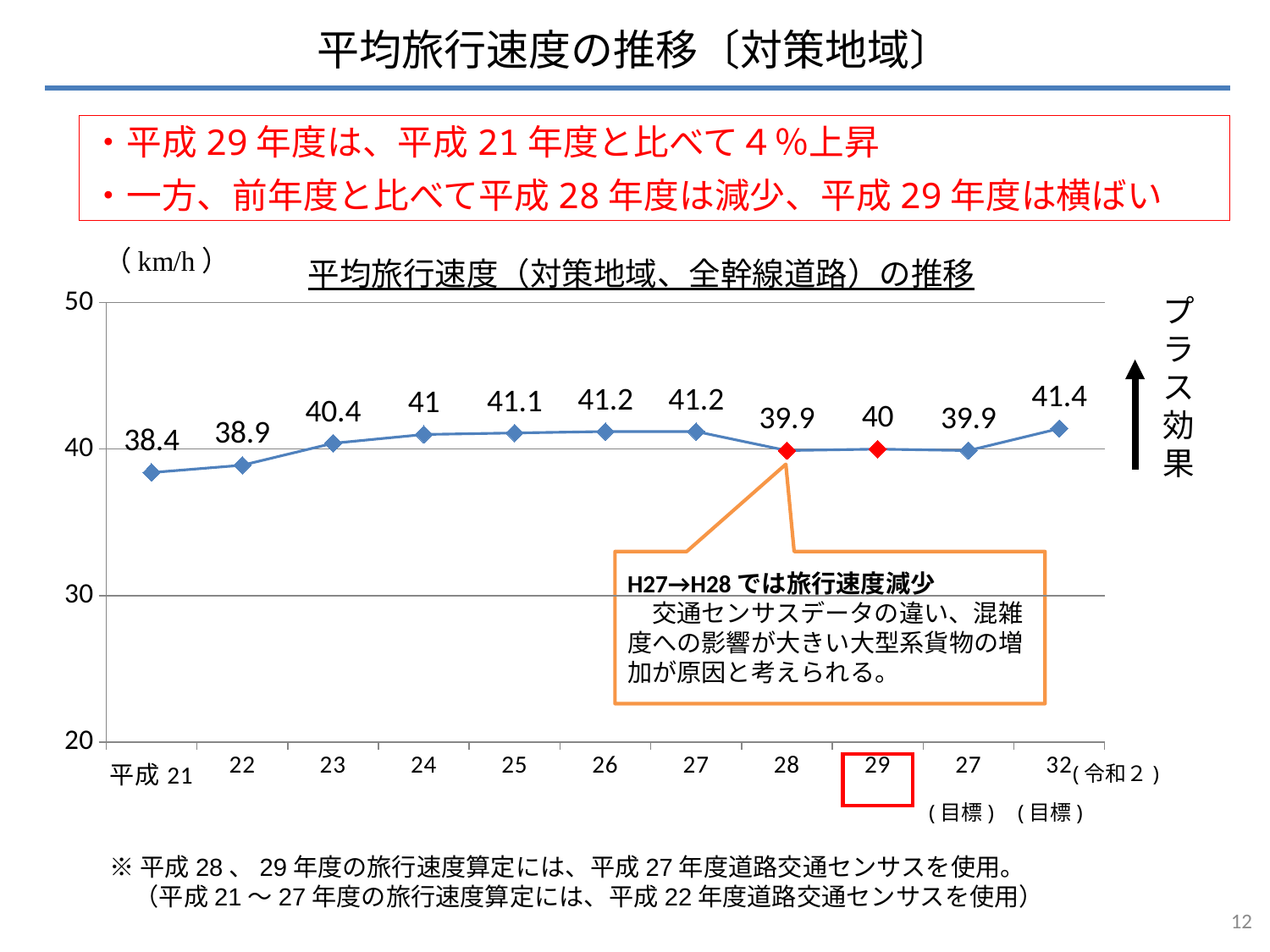
Which is larger, the value for 平成23 or the value for 平成28? 平成23 What is the value for 平成21 in the chart 平均旅行速度（対策地域、全幹線道路）の推移? 38.4 What is the value for 32（目標）(令和2) in the chart? 41.4 What kind of chart is shown on the slide? line chart Which point on the chart has the lowest value? 平成21 How many data points are plotted on the chart? 11 What is the value for 平成29 in the chart? 40 What unit is shown for the y axis of the chart? km/h What is the difference between the values for 平成27 and 平成28? 1.3 What is the value for 平成28 in the chart? 39.9 Which point on the chart has the highest value? 32（目標） What is the difference between the values for 平成27 and 平成21? 2.8